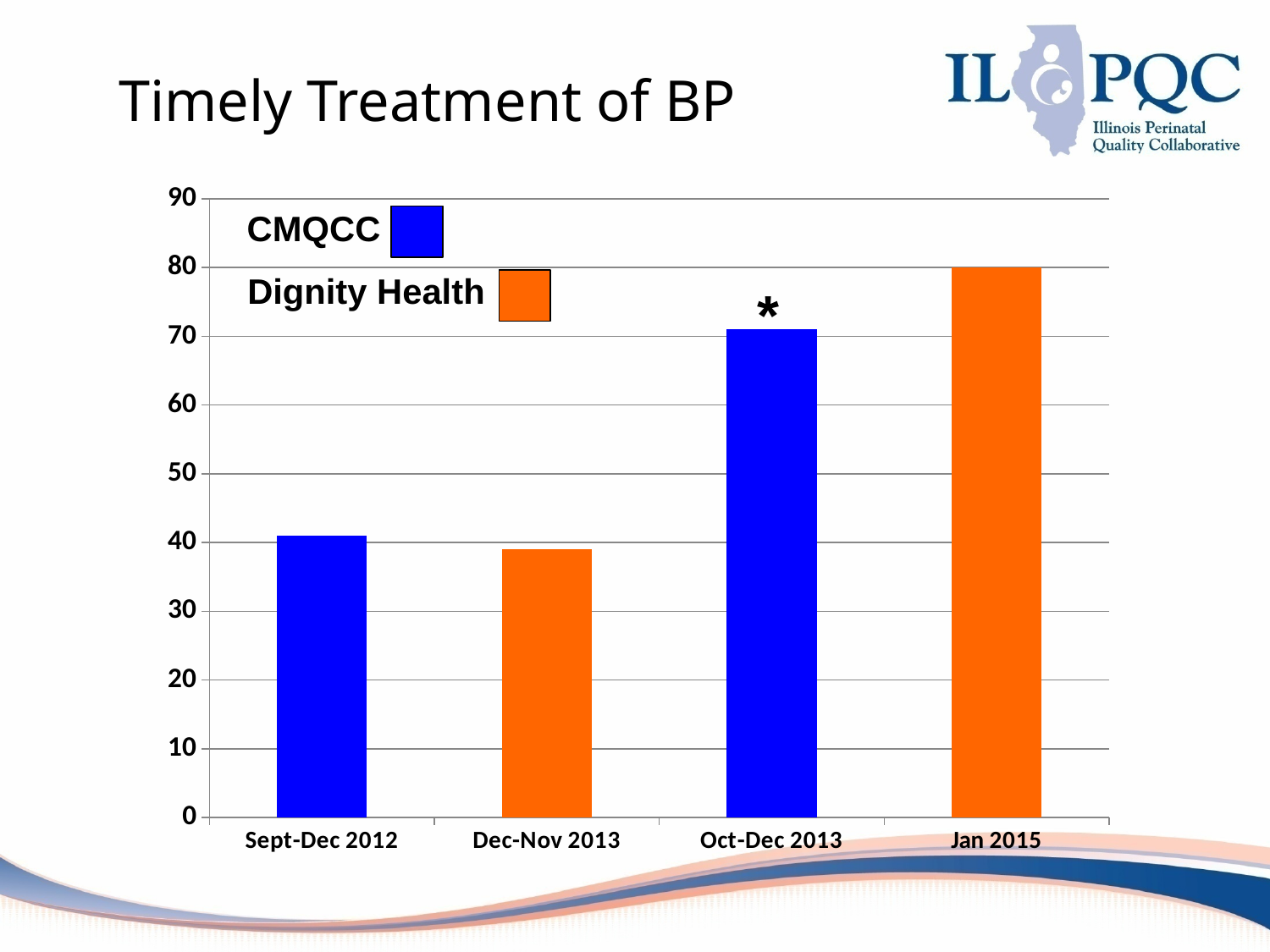
Is the value for Jan 2015 greater or less than 70? greater Which series is shown in orange? Dignity Health What kind of chart is shown on the slide? bar chart How many series does the legend list? 2 How many categories are shown on the x axis? 4 What is the title of the slide? Timely Treatment of BP Which category has the lowest bar? Dec-Nov 2013 Which category has the highest bar? Jan 2015 Is the value for Sept-Dec 2012 greater or less than 50? less Which is larger, the value for Oct-Dec 2013 or the value for Sept-Dec 2012? Oct-Dec 2013